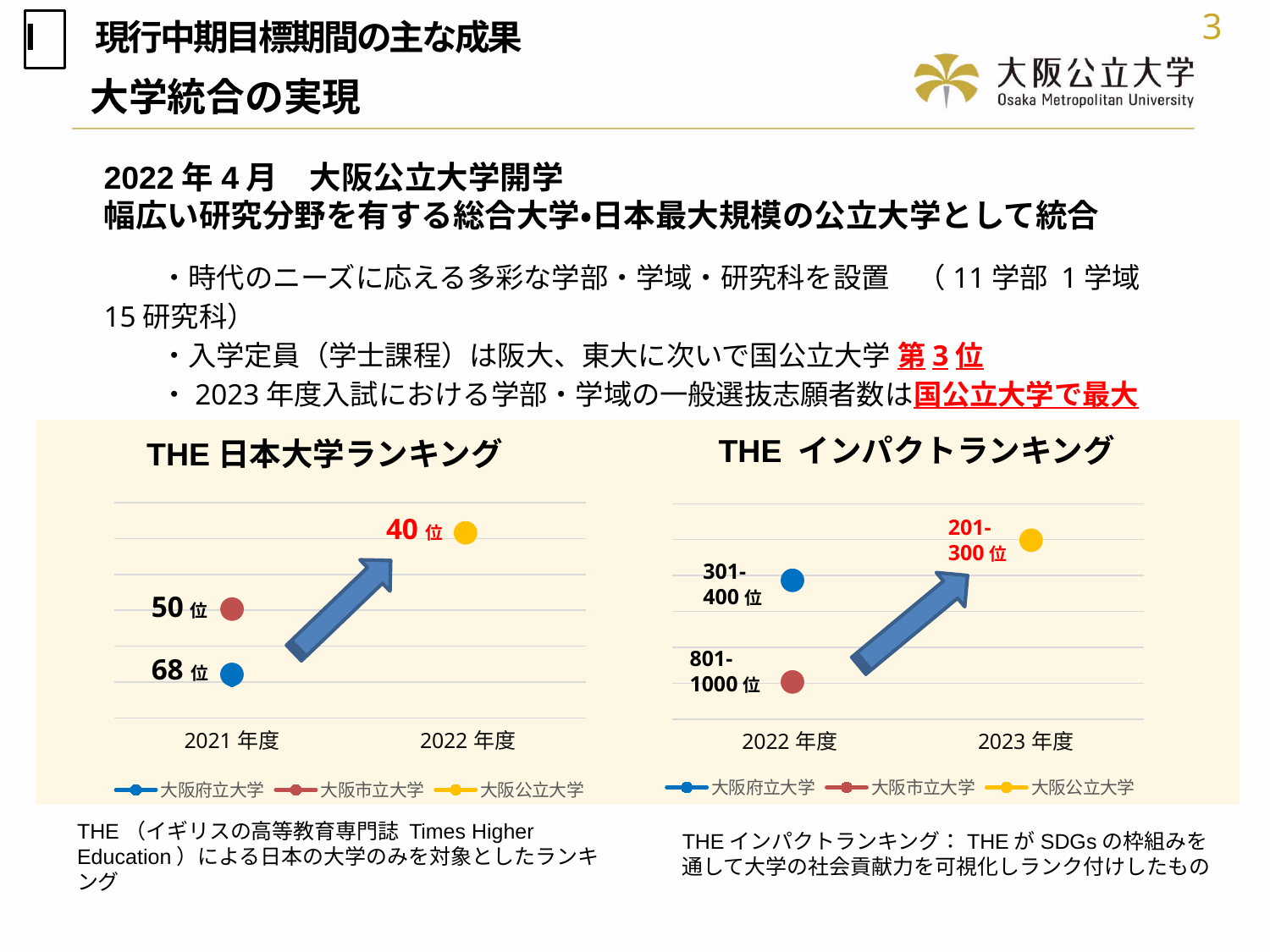
In the THE インパクトランキング chart, what is the value shown for 大阪市立大学 in 2022年度? 801-1000位 In the THE 日本大学ランキング chart, what is the value shown for 大阪府立大学 in 2021年度? 68位 In the THE インパクトランキング chart, what colour is the marker for 大阪公立大学 in the legend? Yellow How many series does the legend of the THE インパクトランキング chart list? 3 In the THE 日本大学ランキング chart, what is the numeric difference between the 2021年度 values for 大阪府立大学 (68位) and 大阪市立大学 (50位)? 18 In the THE インパクトランキング chart, what is the value shown for 大阪府立大学 in 2022年度? 301-400位 In the THE 日本大学ランキング chart, what is the value shown for 大阪市立大学 in 2021年度? 50位 In the THE 日本大学ランキング chart, which series has the numerically larger value in 2021年度, 大阪府立大学 or 大阪市立大学? 大阪府立大学 How many series does the legend of the THE 日本大学ランキング chart list? 3 In the THE 日本大学ランキング chart, what is the value shown for 大阪公立大学 in 2022年度? 40位 How many year categories are shown on the x axis of the THE 日本大学ランキング chart? 2 In the THE インパクトランキング chart, what is the value shown for 大阪公立大学 in 2023年度? 201-300位